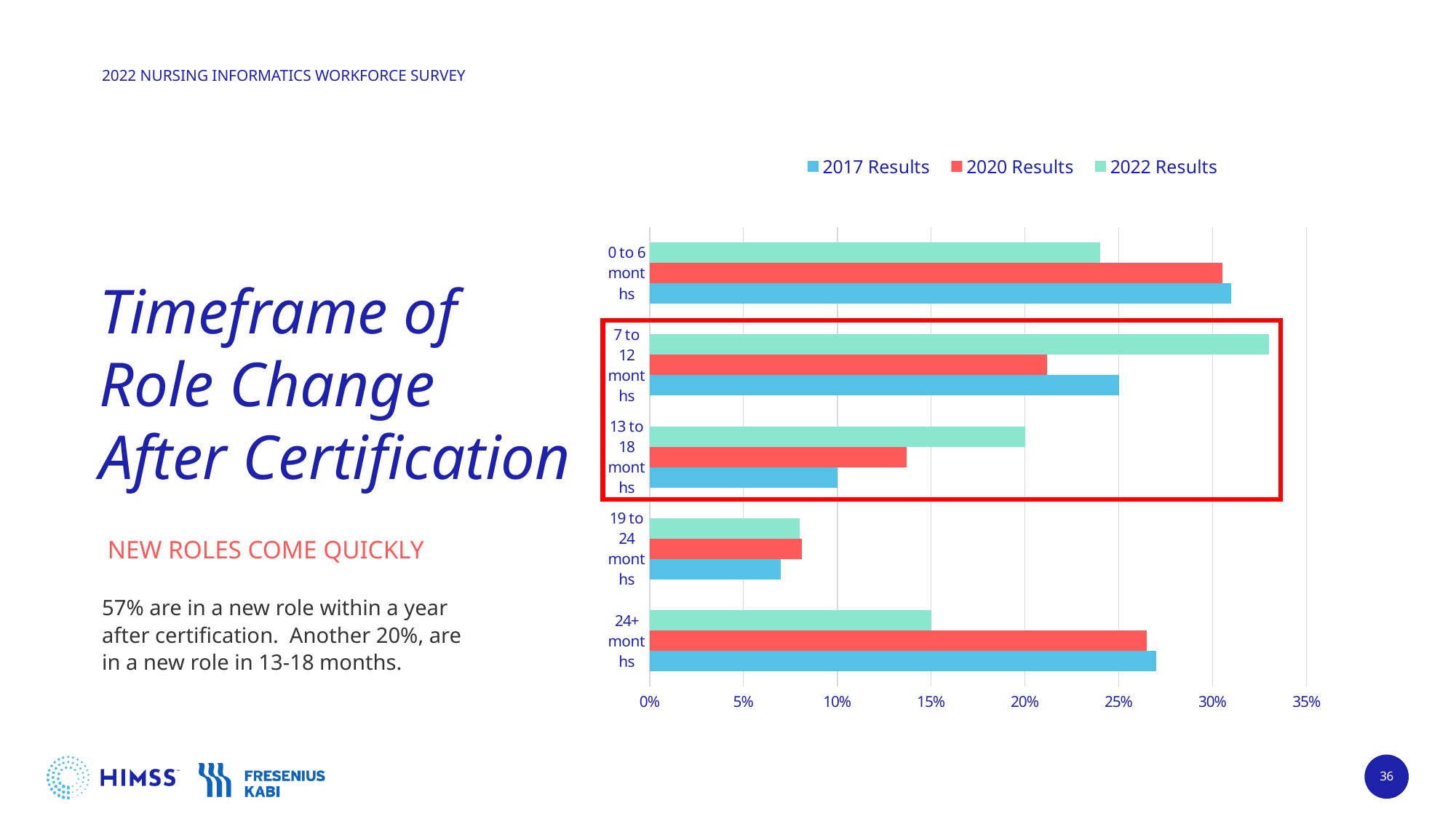
Is the 2022 Results value for 7 to 12 months greater or less than 30%? greater How many timeframe categories are plotted on the chart? 5 Which timeframe category has the lowest value for 2020 Results? 19 to 24 months What kind of chart is shown on the slide? bar chart For the 7 to 12 months category, which is larger: the 2022 Results value or the 2020 Results value? 2022 Results Which timeframe category has the highest value for 2017 Results? 0 to 6 months Which timeframe category has the highest value for 2022 Results? 7 to 12 months For the 0 to 6 months category, which is larger: the 2017 Results value or the 2022 Results value? 2017 Results Which timeframe category has the lowest value for 2022 Results? 19 to 24 months How many series does the chart legend list? 3 Is the 2017 Results value for 13 to 18 months greater or less than 15%? less Which series are listed in the chart legend? 2017 Results, 2020 Results, 2022 Results